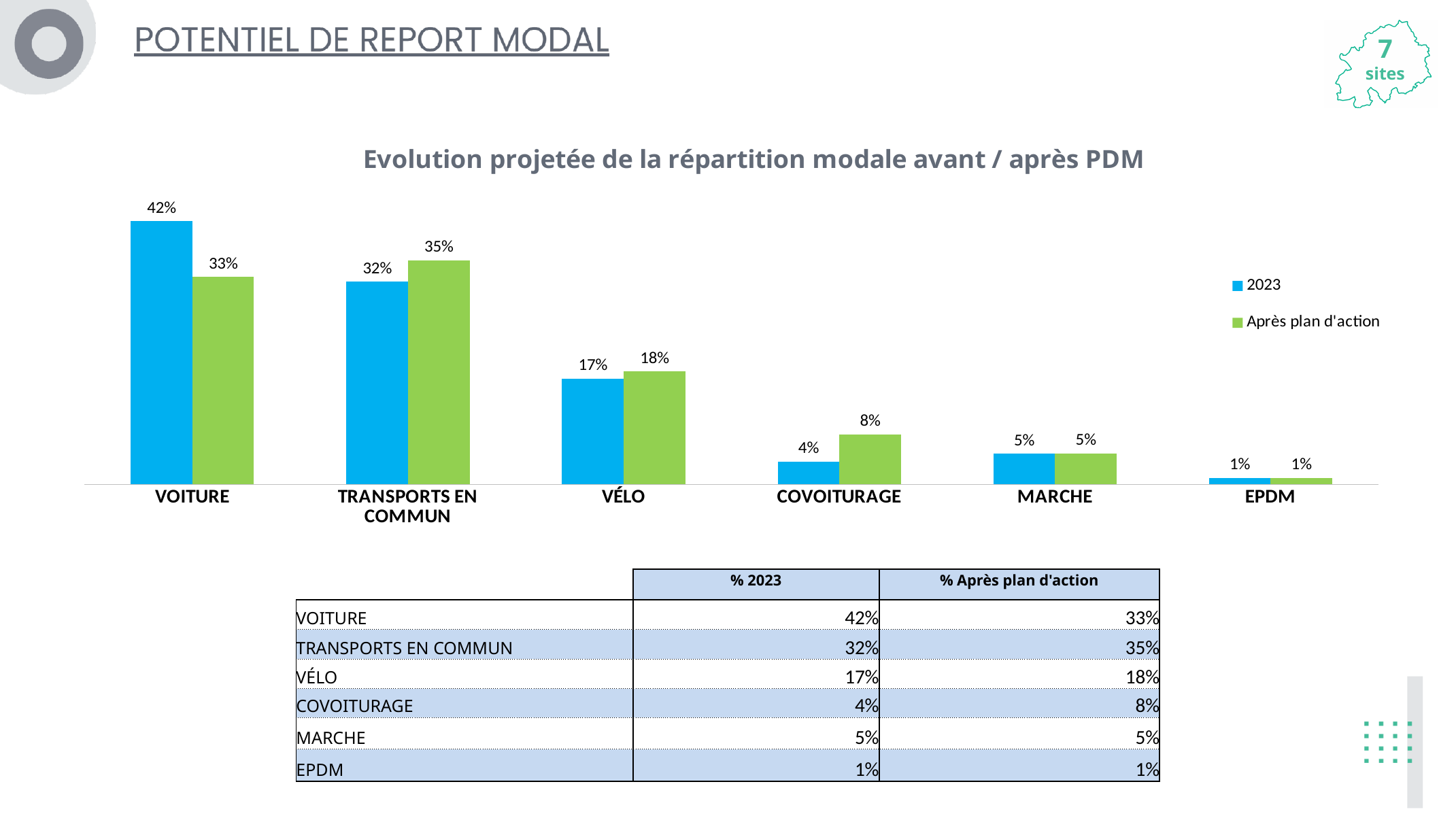
Which category has the highest 2023 value? VOITURE What is the difference between the 2023 and Après plan d'action values for VOITURE? 9% How many categories are shown on the x axis? 6 What kind of chart is shown on the slide? Bar chart Which category has the lowest Après plan d'action value? EPDM What is the Après plan d'action value for COVOITURAGE? 8% What is the difference between the Après plan d'action values for TRANSPORTS EN COMMUN and VÉLO? 17% What is the 2023 value for VOITURE? 42% What is the title of the chart? Evolution projetée de la répartition modale avant / après PDM What is the Après plan d'action value for TRANSPORTS EN COMMUN? 35% How many series does the legend list? 2 Which is larger for TRANSPORTS EN COMMUN: the 2023 value or the Après plan d'action value? Après plan d'action